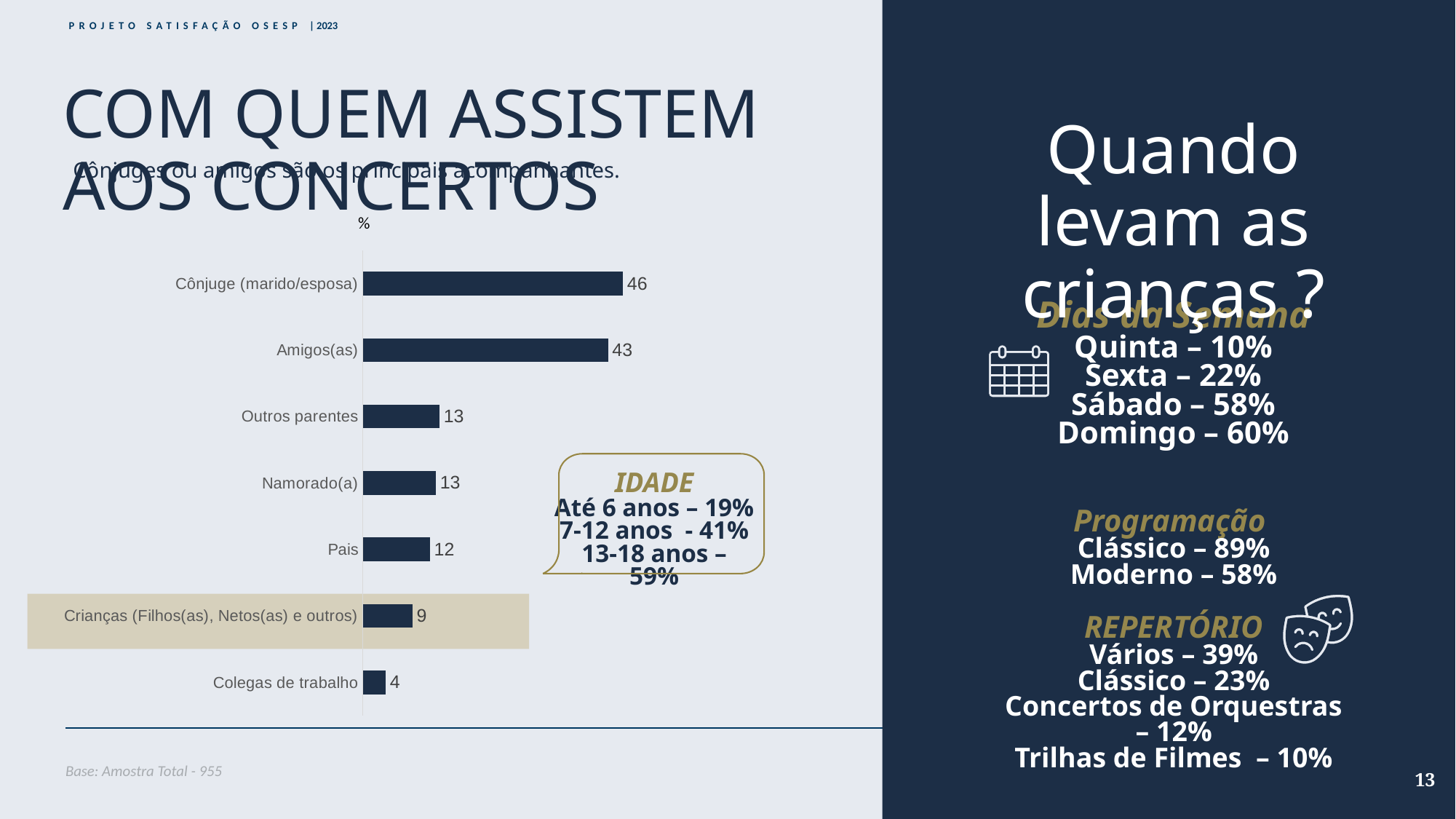
What is the difference between the values for Cônjuge (marido/esposa) and Amigos(as)? 3 What kind of chart is shown on the slide? Bar chart Which category's row is highlighted with a beige background in the chart? Crianças (Filhos(as), Netos(as) e outros) What is the value for Amigos(as)? 43 Which category has the highest value? Cônjuge (marido/esposa) What is the value for Cônjuge (marido/esposa)? 46 Which is larger, the value for Pais or the value for Crianças (Filhos(as), Netos(as) e outros)? Pais What is the value for Colegas de trabalho? 4 Which category has the lowest value? Colegas de trabalho How many categories are shown in the chart? 7 What is the difference between the values for Outros parentes and Colegas de trabalho? 9 What is the value for Crianças (Filhos(as), Netos(as) e outros)? 9